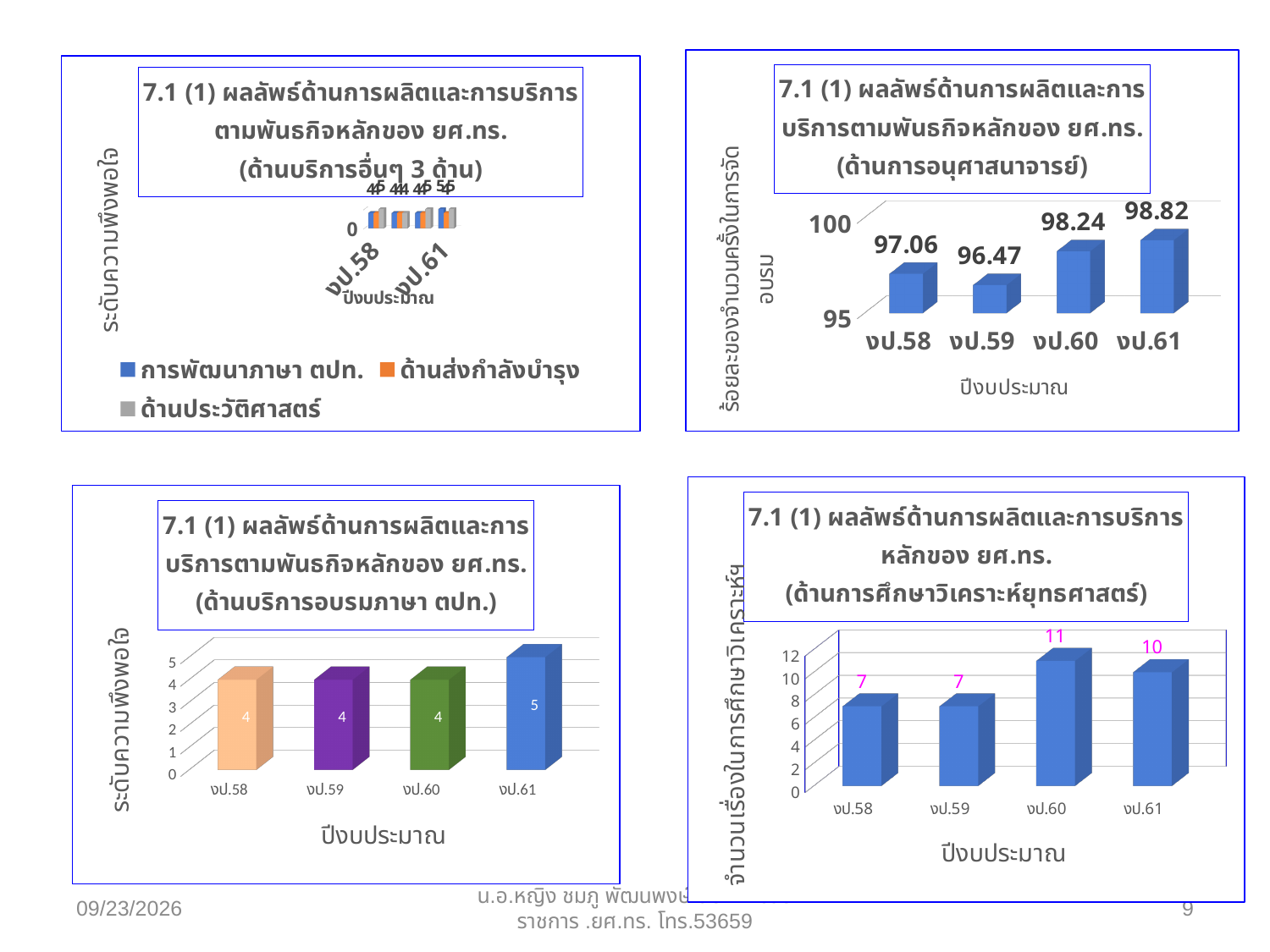
In the top-right chart (ด้านการอนุศาสนาจารย์), which fiscal year has the lowest value? งป.59 In the top-right chart (ด้านการอนุศาสนาจารย์), what is the difference between the values for งป.61 and งป.59? 2.35 In the bottom-right chart (ด้านการศึกษาวิเคราะห์ยุทธศาสตร์), what is the difference between the values for งป.60 and งป.58? 4 In the bottom-left chart (ด้านบริการอบรมภาษา ตปท.), how many fiscal years are shown on the x axis? 4 In the bottom-left chart (ด้านบริการอบรมภาษา ตปท.), what is the value for งป.61? 5 In the top-right chart (ด้านการอนุศาสนาจารย์), which fiscal year has the highest value? งป.61 In the bottom-right chart (ด้านการศึกษาวิเคราะห์ยุทธศาสตร์), what is the value for งป.60? 11 How many series does the legend of the top-left chart (ด้านบริการอื่นๆ 3 ด้าน) list? 3 What kind of chart is the bottom-right chart (ด้านการศึกษาวิเคราะห์ยุทธศาสตร์)? bar chart In the top-right chart (ด้านการอนุศาสนาจารย์), what is the value for งป.58? 97.06 In the bottom-right chart (ด้านการศึกษาวิเคราะห์ยุทธศาสตร์), which is larger, the value for งป.60 or งป.61? งป.60 What is the x-axis title of the bottom-left chart (ด้านบริการอบรมภาษา ตปท.)? ปีงบประมาณ